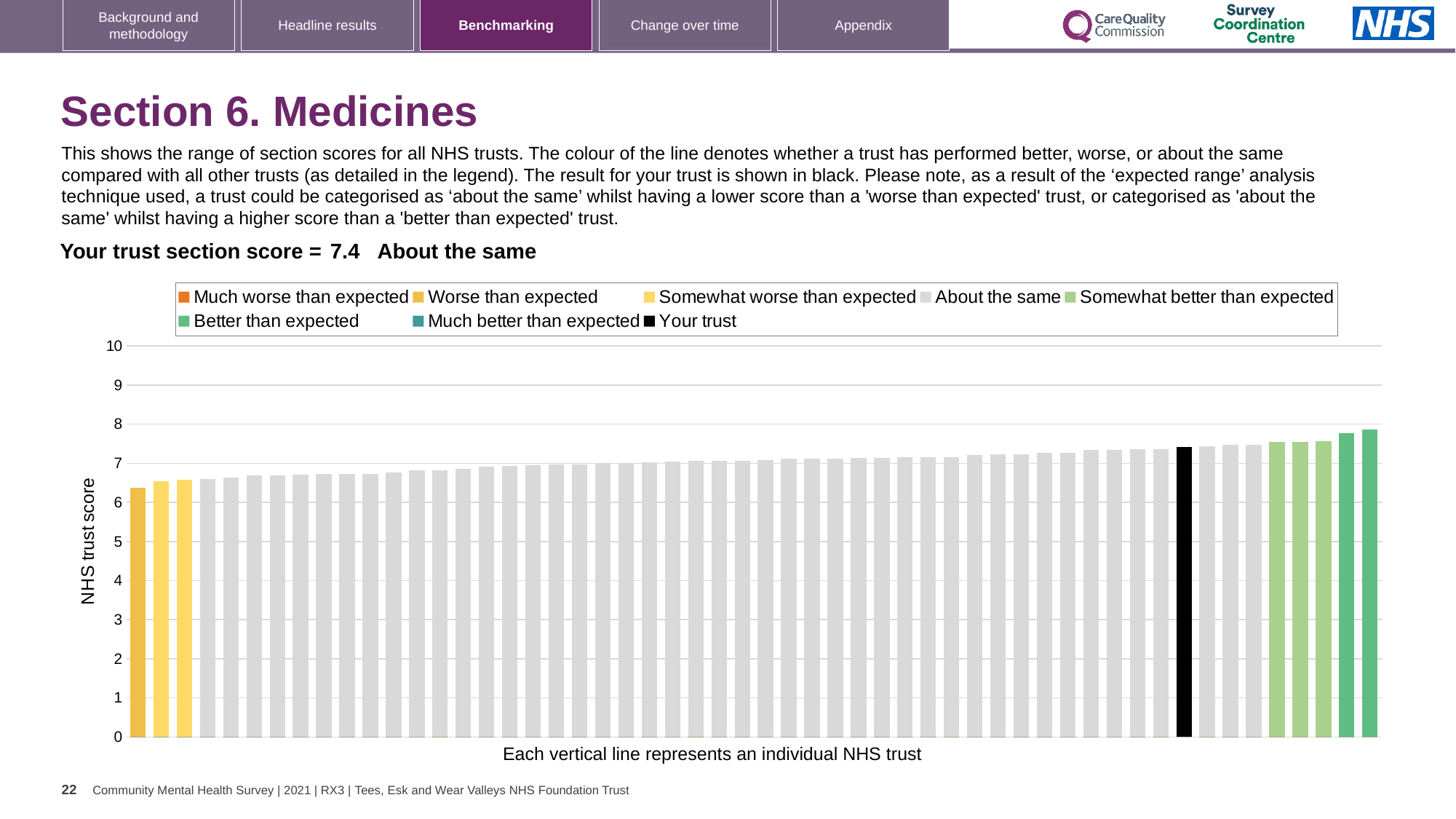
Is the value of the lowest bar in the chart greater or less than 7? less What colour is used for the bar representing your trust? Black Do the bar values rise or fall moving from left to right along the x axis? Rise What kind of chart is shown on the slide? Bar chart What is the highest value shown on the vertical axis? 10 What is the label on the vertical axis of the chart? NHS trust score Is your trust's bar higher or lower than the tallest bar in the chart? Lower How many entries does the chart legend list? 8 How is your trust categorised compared with other trusts, according to the text above the chart? About the same Is the value of the tallest bar in the chart greater or less than 7? greater Is the value for your trust (the black bar) greater or less than 7? greater What is the section score for your trust shown on the slide? 7.4